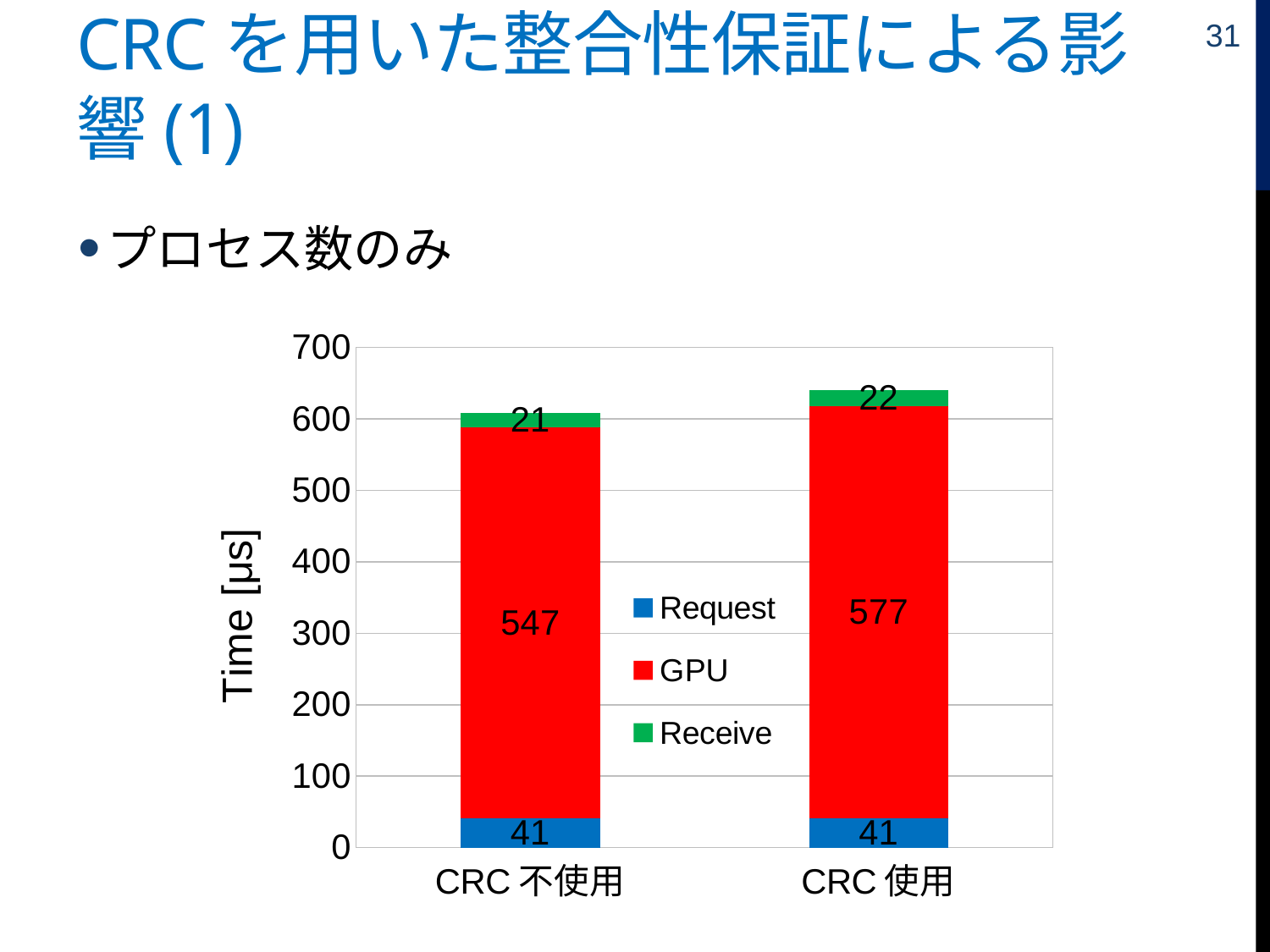
What kind of chart is shown? stacked bar chart How many series does the legend list? 3 What is the Receive value for CRC 使用? 22 How many categories are shown on the x axis? 2 What is the label of the y axis? Time [μs] What is the GPU value for CRC 使用? 577 What is the difference between the GPU values for CRC 使用 and CRC 不使用? 30 What is the GPU value for CRC 不使用? 547 What is the Request value for CRC 不使用? 41 Which category has the larger GPU value, CRC 不使用 or CRC 使用? CRC 使用 What is the total of the stacked bar for CRC 不使用? 609 What is the total of the stacked bar for CRC 使用? 640